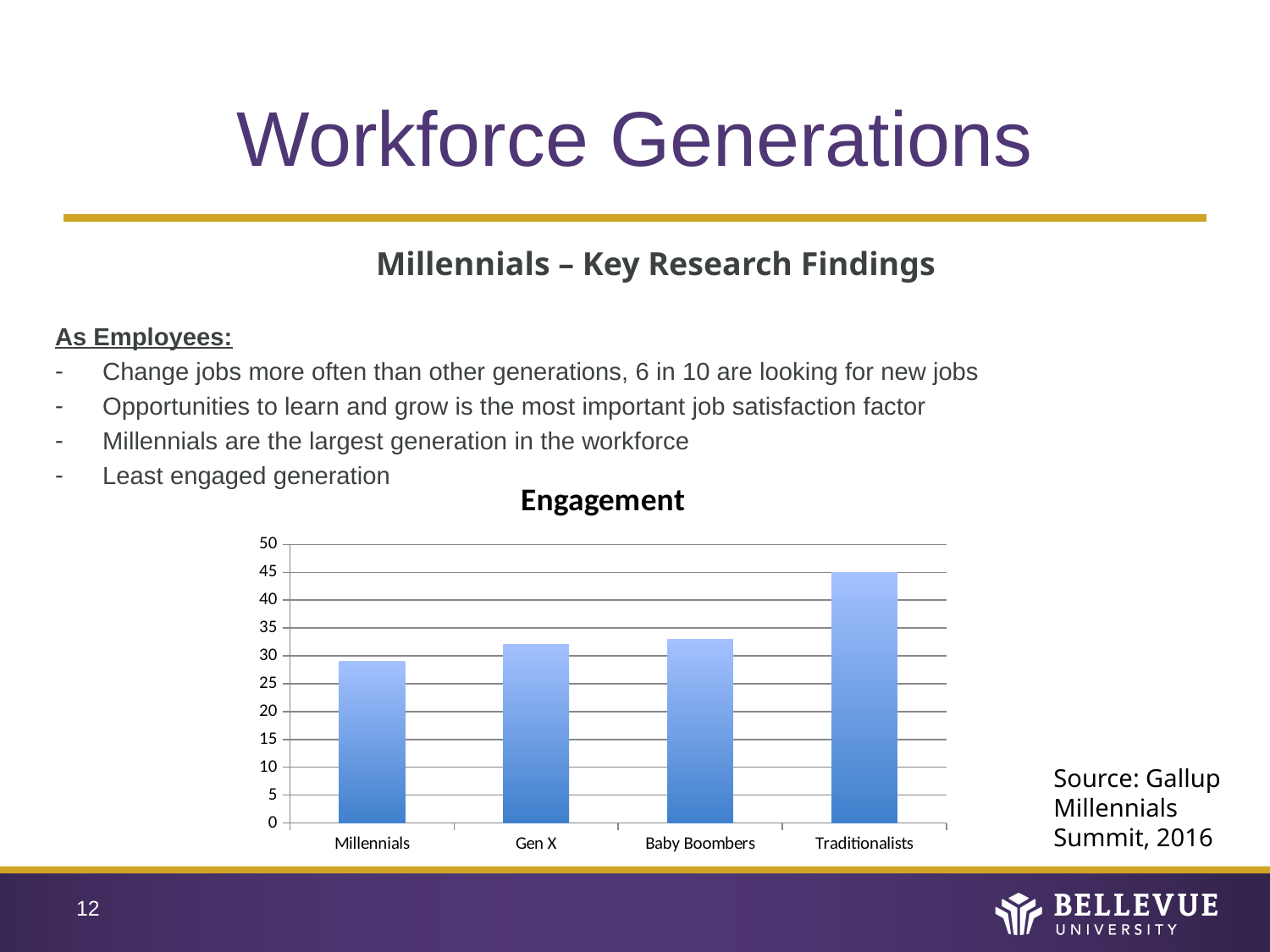
Which has a higher engagement value, Millennials or Traditionalists? Traditionalists Do the engagement values rise or fall moving from Millennials to Traditionalists along the x axis? rise What is the title of the chart? Engagement How many generations are plotted in the Engagement chart? 4 Is the engagement value for Traditionalists greater or less than 40? greater What is the engagement value for Traditionalists? 45 Which generation has the highest engagement value in the chart? Traditionalists What kind of chart is shown on the slide? bar chart Is the engagement value for Baby Boomers greater or less than 35? less Which generation has the lowest engagement value in the chart? Millennials Is the engagement value for Gen X greater or less than 30? greater